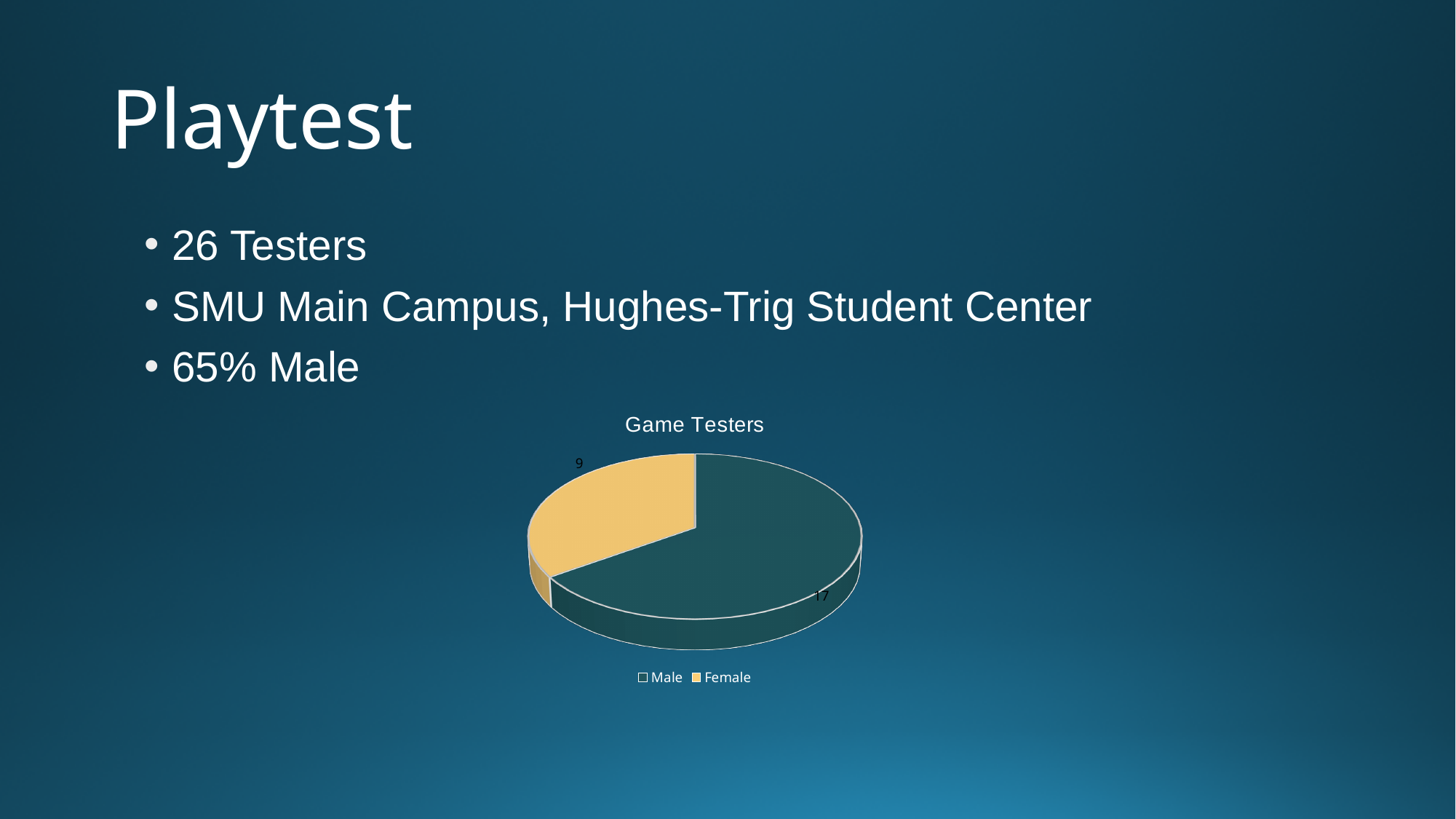
What is the value for Female in the pie chart? 9 What kind of chart is shown on the slide? pie chart Which slice of the pie chart is the smallest? Female What is the title of the chart? Game Testers What is the difference between the Male and Female values in the pie chart? 8 What is the value for Male in the pie chart? 17 How many slices does the pie chart have? 2 What share of the pie does the Male slice represent? 65% How many entries does the chart legend list? 2 Which slice of the pie chart is the largest? Male Which is larger in the pie chart, Male or Female? Male What is the total of all slices in the pie chart? 26